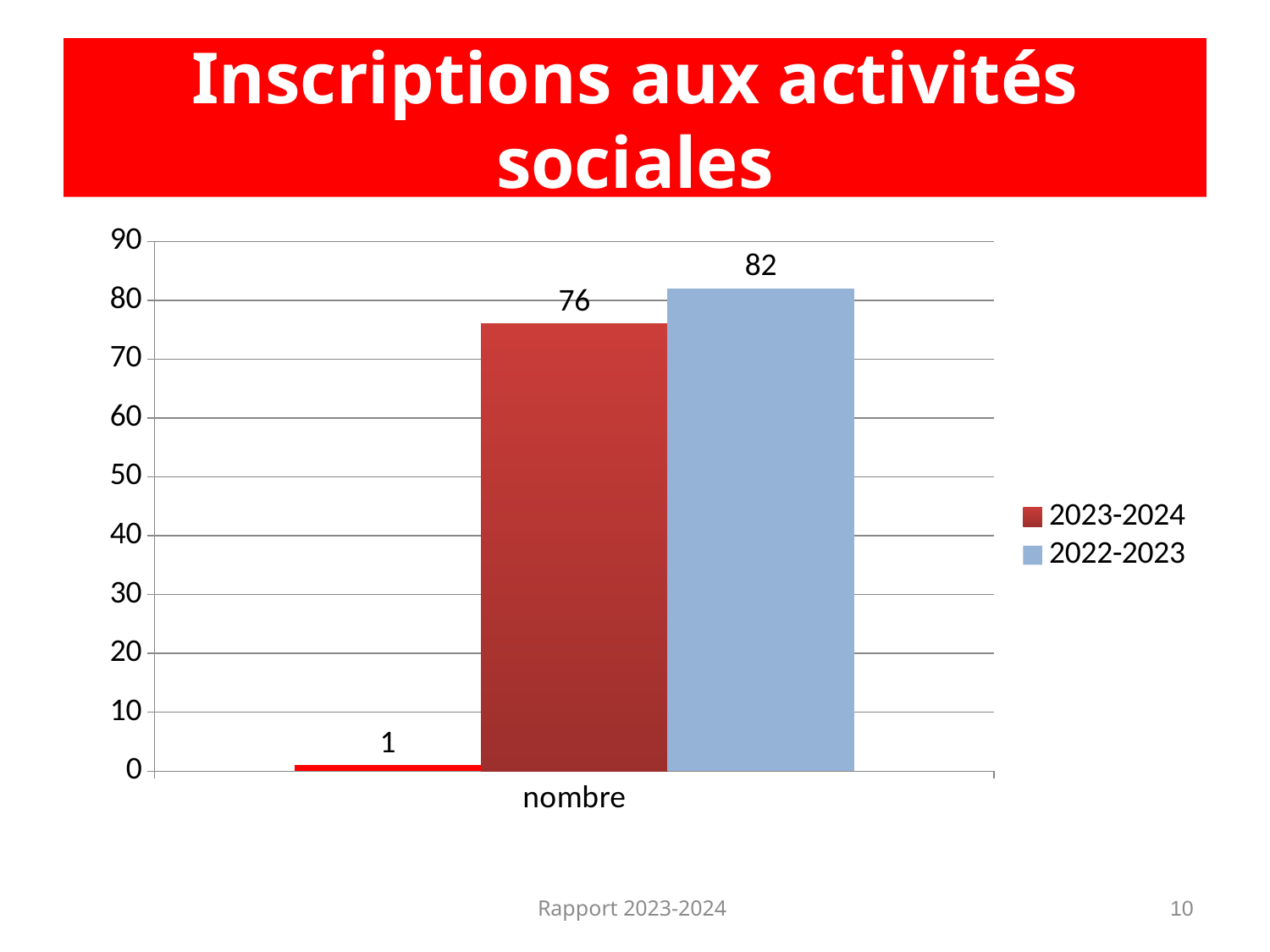
Which series has the higher value, 2023-2024 or 2022-2023? 2022-2023 How many series does the legend list? 2 What is the difference between the 2022-2023 value and the 2023-2024 value? 6 Is the value for 2022-2023 greater or less than 80? greater What is the highest value shown on the y axis of the chart? 90 What is the value for 2022-2023 in the chart? 82 What is the data label on the leftmost (red) bar of the chart? 1 What is the value for 2023-2024 in the chart? 76 What is the category label shown on the x axis of the chart? nombre What is the title of the chart on the slide? Inscriptions aux activités sociales What kind of chart is shown on the slide? bar chart Is the value for 2023-2024 greater or less than 80? less